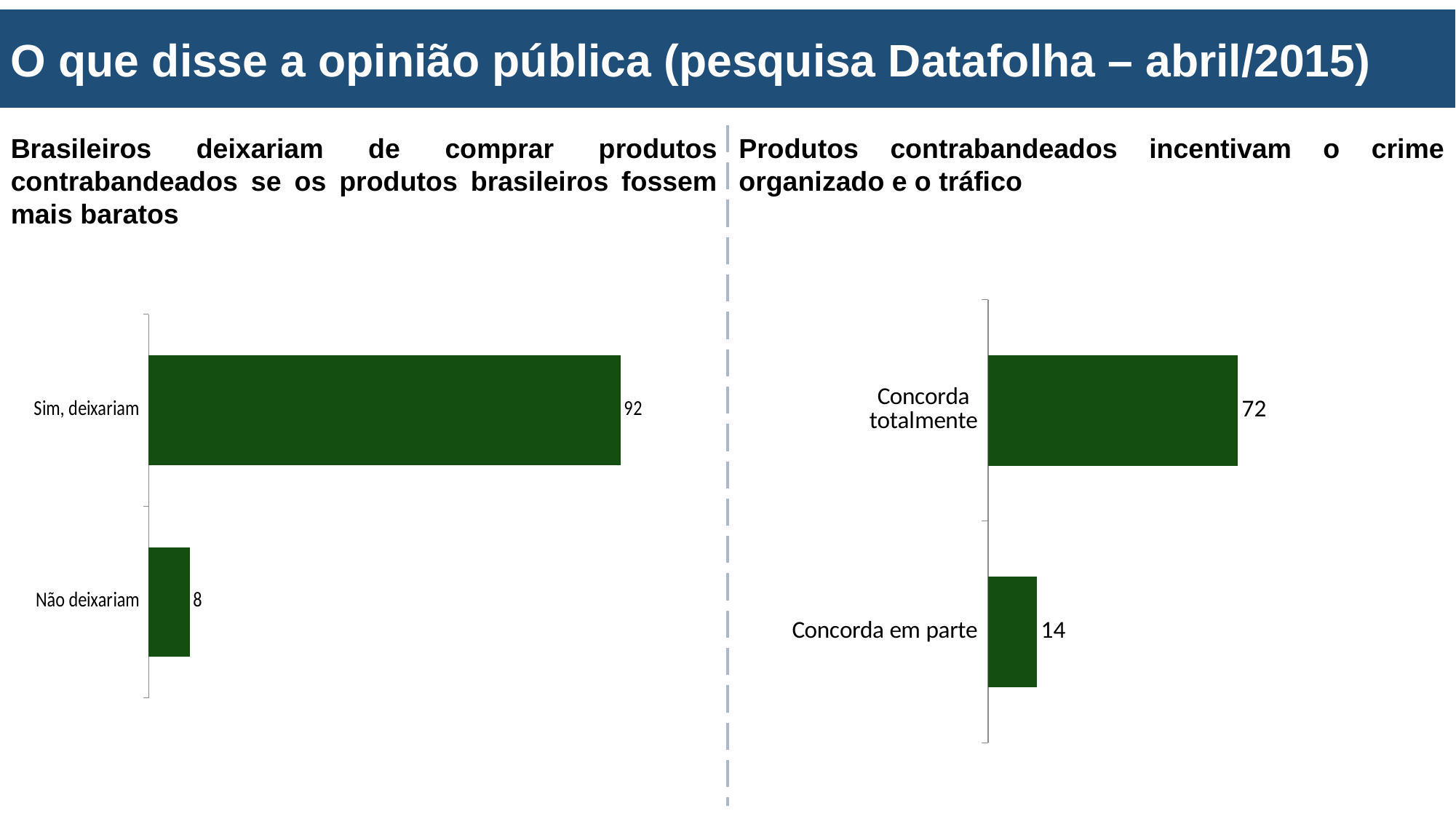
In the left chart, what is the value for "Sim, deixariam"? 92 In the left chart, what is the difference between "Sim, deixariam" and "Não deixariam"? 84 In the right chart, which category has the lowest value? Concorda em parte In the right chart, which is larger: "Concorda totalmente" or "Concorda em parte"? Concorda totalmente In the left chart, what is the value for "Não deixariam"? 8 What is the title of the slide? O que disse a opinião pública (pesquisa Datafolha – abril/2015) In the right chart, what is the difference between "Concorda totalmente" and "Concorda em parte"? 58 How many categories does the left chart show? 2 What kind of chart is the right chart? Bar chart In the left chart, which category has the highest value? Sim, deixariam In the right chart, what is the value for "Concorda em parte"? 14 In the right chart, what is the value for "Concorda totalmente"? 72